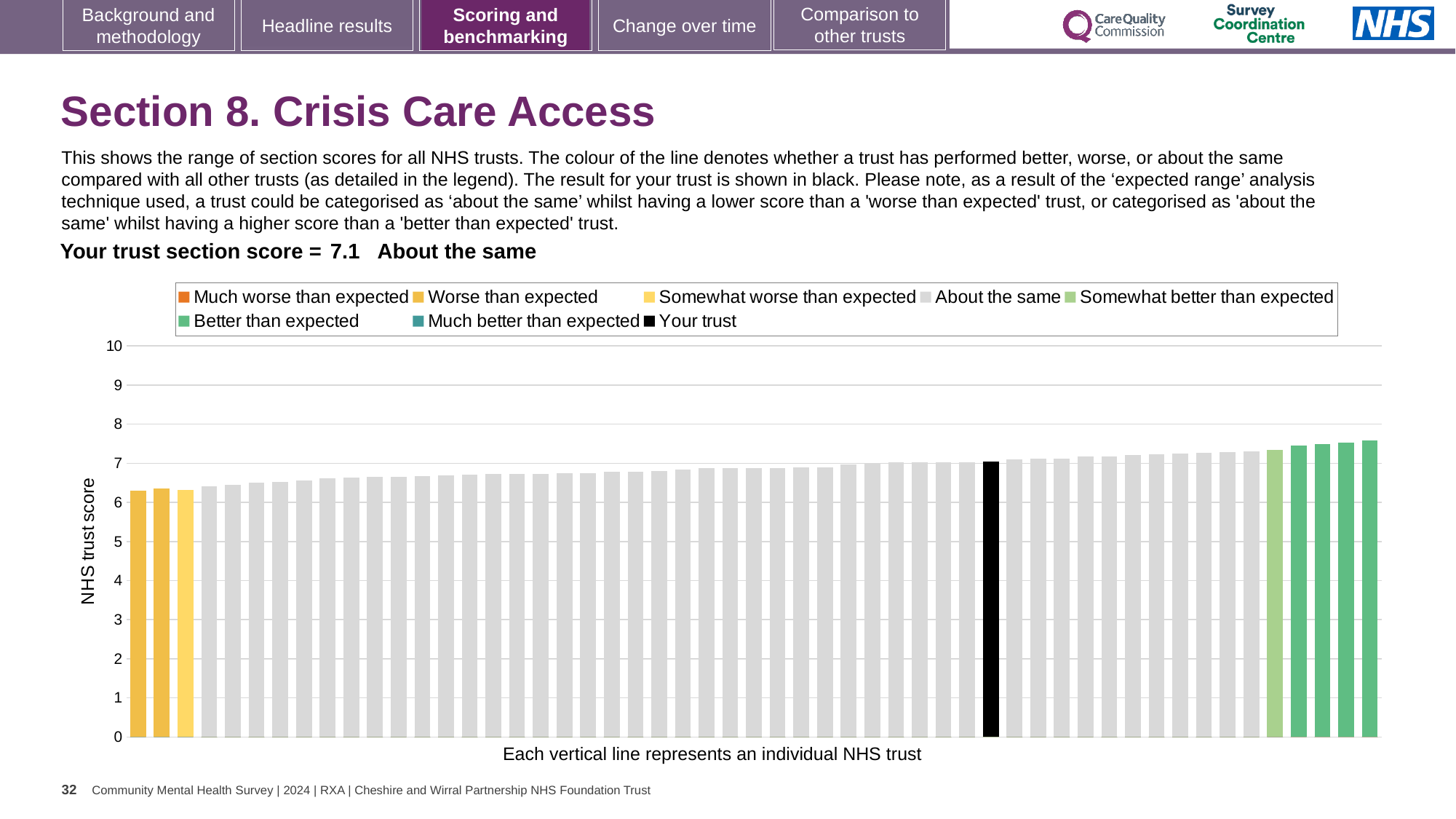
Is the value of the tallest bar greater or less than 8? less What is your trust's section score for Crisis Care Access? 7.1 Which is larger, the black 'Your trust' bar or the leftmost yellow bar? The black 'Your trust' bar Do the bar values rise or fall from left to right along the x axis? Rise What kind of chart is shown on the slide? Bar chart How many bars are coloured as 'Better than expected'? 4 How many entries does the chart legend list? 8 What category is your trust's section score placed in? About the same What is the label on the vertical axis of the chart? NHS trust score Is the value of the black 'Your trust' bar greater or less than 5? greater Is the value of the shortest bar greater or less than 5? greater How many bars are coloured as 'Worse than expected'? 2